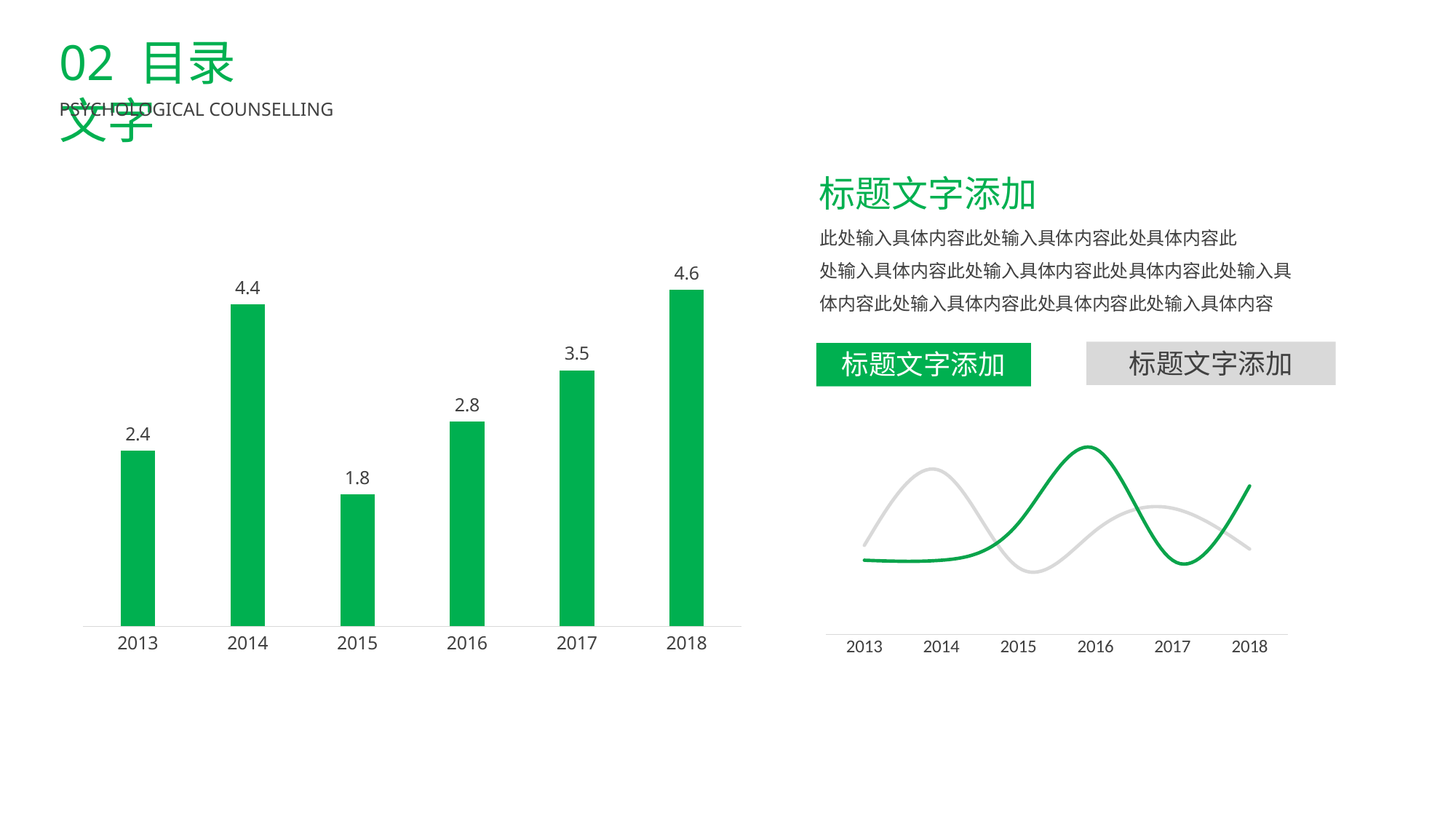
In the bar chart on the left, what is the value for 2015? 1.8 In the bar chart on the left, what is the value for 2017? 3.5 In the bar chart on the left, which is larger, the value for 2016 or the value for 2017? 2017 In the bar chart on the left, which year has the highest value? 2018 In the bar chart on the left, which year has the lowest value? 2015 What kind of chart is the chart on the left of the slide? Bar chart How many bars are shown in the bar chart on the left? 6 In the bar chart on the left, what is the value for 2014? 4.4 In the bar chart on the left, what is the difference between the values for 2018 and 2013? 2.2 What kind of chart is the chart on the right of the slide? Line chart How many lines are plotted in the line chart on the right? 2 In the bar chart on the left, what is the difference between the values for 2014 and 2015? 2.6